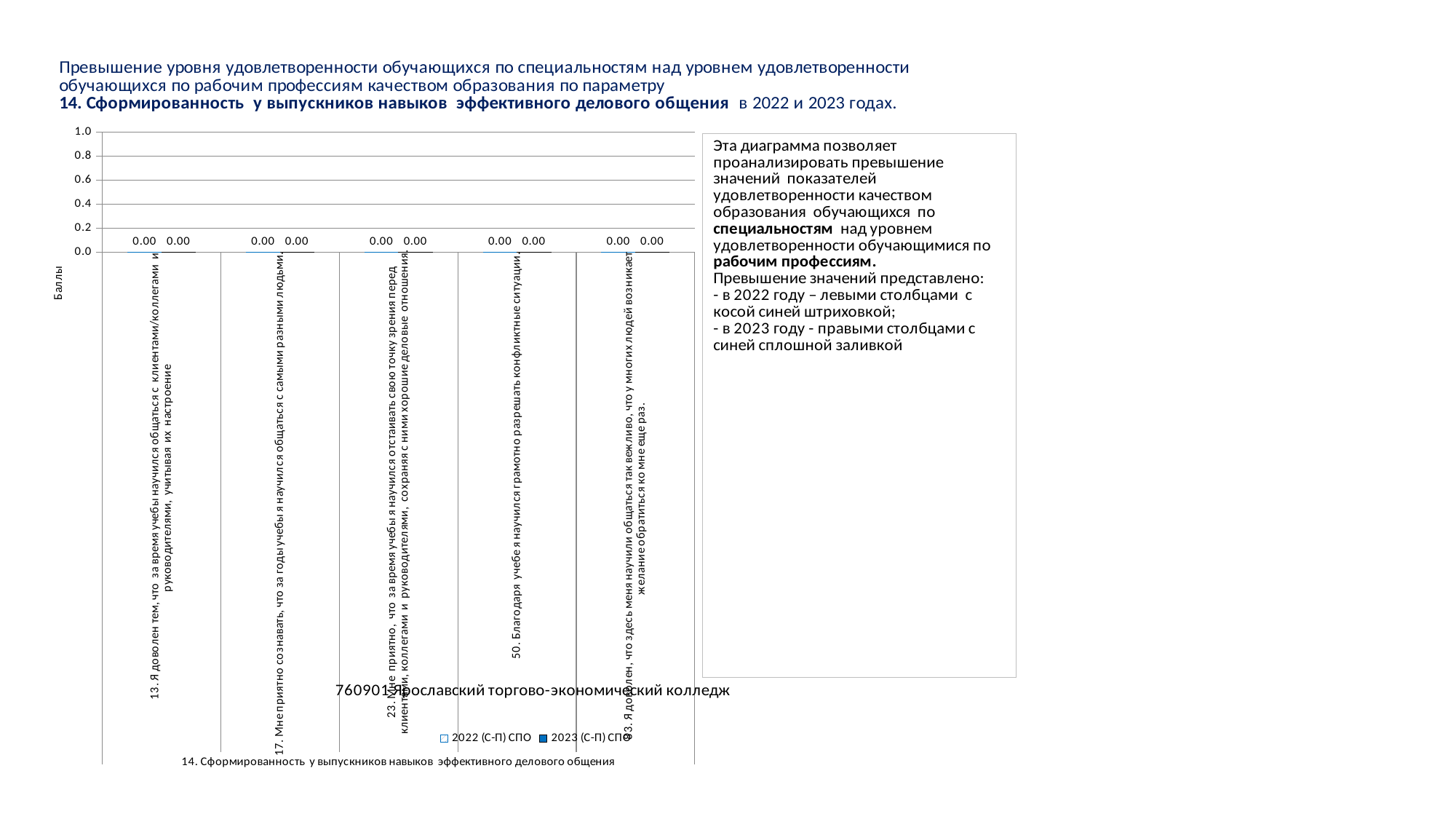
What is the value for 2023 (С-П) СПО for category 50 (Благодаря учебе я научился грамотно разрешать конфликтные ситуации)? 0.00 What kind of chart is shown on the slide? bar chart What are the two series names listed in the chart legend? 2022 (С-П) СПО and 2023 (С-П) СПО What is the value for 2023 (С-П) СПО for category 17 (Мне приятно сознавать, что за годы учебы я научился общаться с самыми разными людьми)? 0.00 How many series does the chart legend list? 2 What is the difference between the 2022 (С-П) СПО and 2023 (С-П) СПО values for category 23? 0.00 What is the title of the vertical axis of the chart? Баллы What is the value for 2022 (С-П) СПО for category 13 (Я доволен тем, что за время учебы научился общаться с клиентами/коллегами и руководителями)? 0.00 How many categories are shown on the x axis of the chart? 5 Is the value for 2023 (С-П) СПО for category 13 greater or less than 0.2? less Do the values for 2022 (С-П) СПО rise, fall, or stay the same across the categories? stay the same